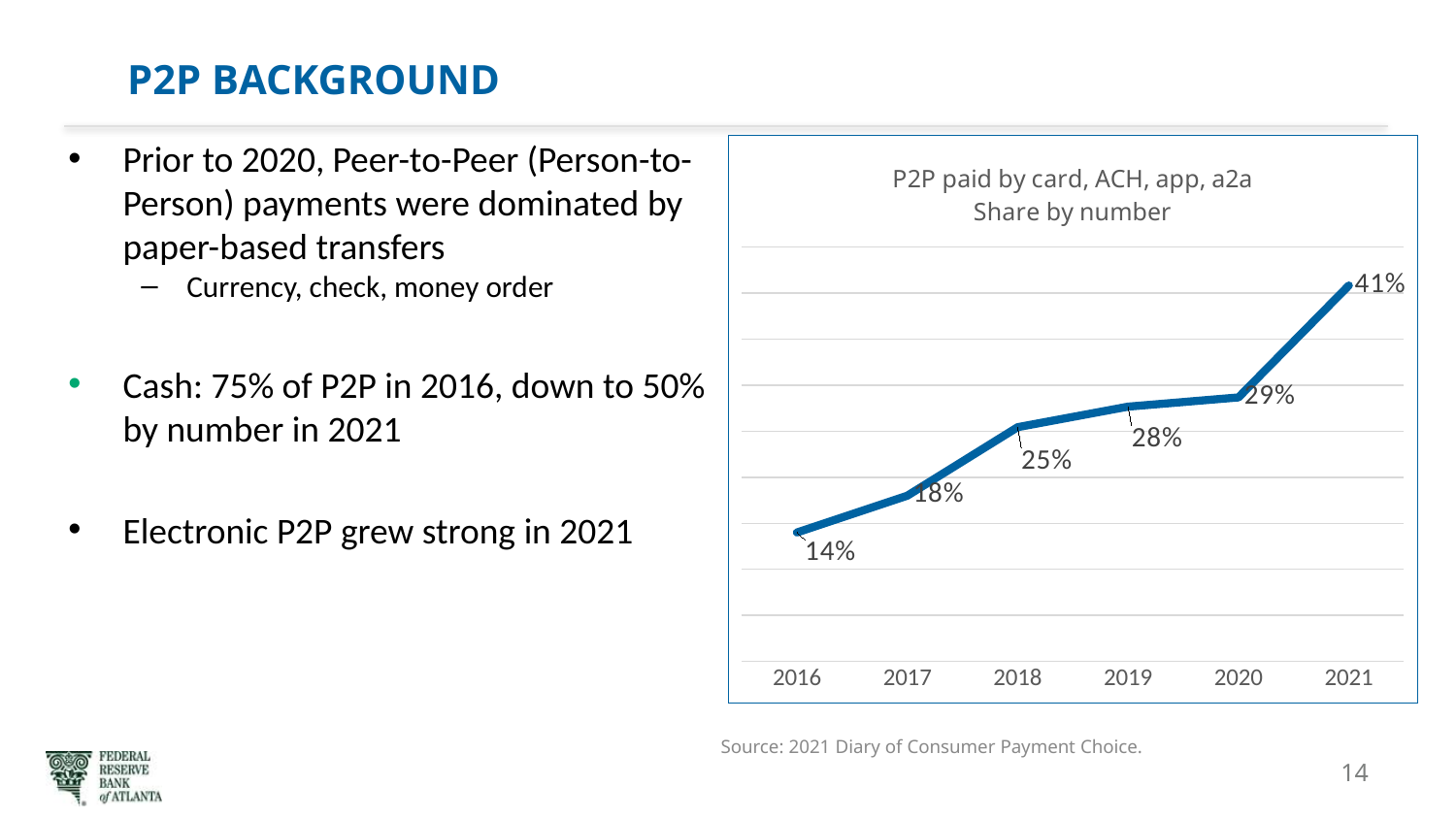
Which year has the highest value? 2021 How many years are plotted on the chart? 6 What is the difference between the values for 2018 and 2016? 11% Do the values rise or fall from 2016 to 2021? rise Which year has the lowest value? 2016 What is the value for 2021? 41% What is the value for 2020? 29% What is the value for 2018? 25% What kind of chart is shown? line chart What is the difference between the values for 2021 and 2020? 12% What is the value for 2016? 14% Which is larger, the value for 2019 or the value for 2017? 2019